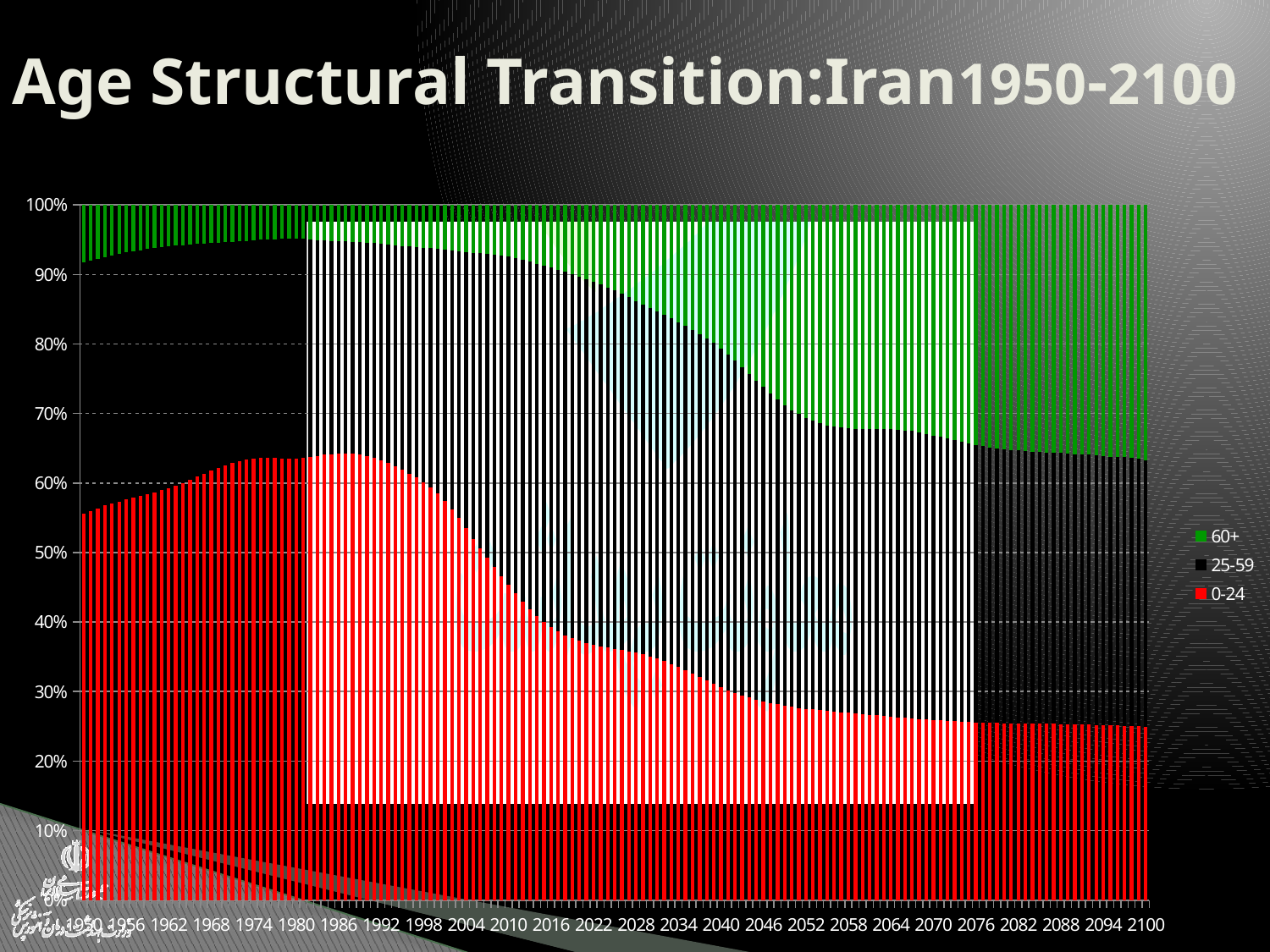
Which age group has the largest share in 1950? 0-24 What kind of chart is shown on the slide? stacked bar chart Which age group has the smallest share in 2100? 0-24 How many series does the legend list? 3 Is the share of the 60+ age group in 2100 greater or less than 30%? greater Which colour represents the 60+ age group? green Is the share of the 60+ age group in 1950 greater or less than 10%? less What are the three age groups listed in the legend? 60+, 25-59, 0-24 Is the share of the 0-24 age group in 1950 greater or less than 50%? greater Is the share of the 0-24 age group larger in 1950 or in 2100? 1950 Does the share of the 60+ age group rise or fall from 1950 to 2100? rise